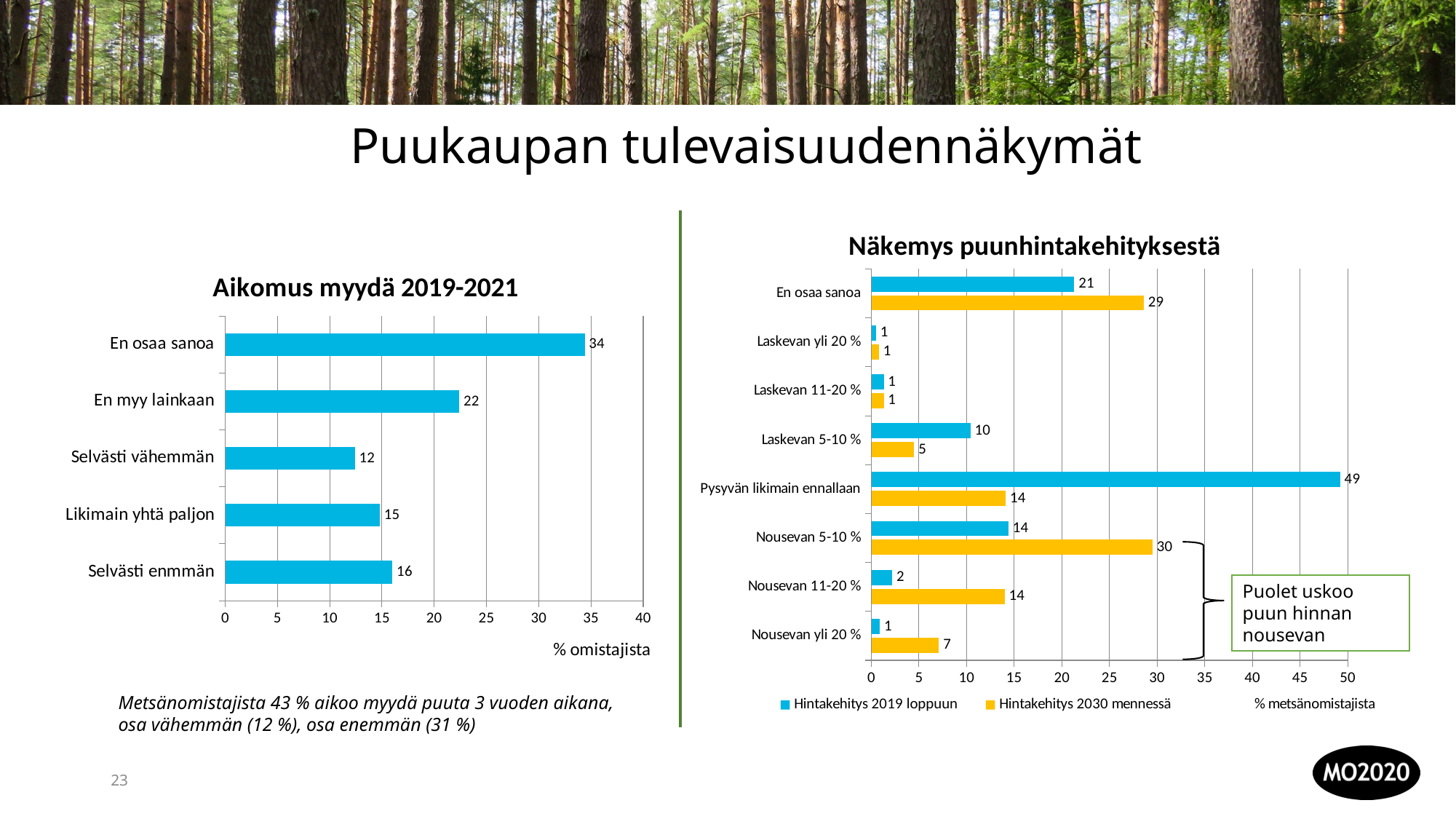
In the 'Näkemys puunhintakehityksestä' chart, what is the value for 'Pysyvän likimain ennallaan' in the 'Hintakehitys 2019 loppuun' series? 49 In the 'Aikomus myydä 2019-2021' chart, which category has the highest value? En osaa sanoa What kind of chart is 'Näkemys puunhintakehityksestä'? Bar chart In the 'Aikomus myydä 2019-2021' chart, which category has the lowest value? Selvästi vähemmän In the 'Aikomus myydä 2019-2021' chart, how many categories are shown? 5 In the 'Näkemys puunhintakehityksestä' chart, how many series does the legend list? 2 In the 'Aikomus myydä 2019-2021' chart, what is the difference between 'En osaa sanoa' and 'En myy lainkaan'? 12 In the 'Näkemys puunhintakehityksestä' chart, what is the difference between the two series for 'Pysyvän likimain ennallaan'? 35 In the 'Aikomus myydä 2019-2021' chart, what is the value for 'En myy lainkaan'? 22 In the 'Näkemys puunhintakehityksestä' chart, what is the value for 'Nousevan 5-10 %' in the 'Hintakehitys 2030 mennessä' series? 30 In the 'Näkemys puunhintakehityksestä' chart, which is larger for 'Nousevan 11-20 %': 'Hintakehitys 2019 loppuun' or 'Hintakehitys 2030 mennessä'? Hintakehitys 2030 mennessä In the 'Näkemys puunhintakehityksestä' chart, what colour represents the 'Hintakehitys 2030 mennessä' series? Yellow